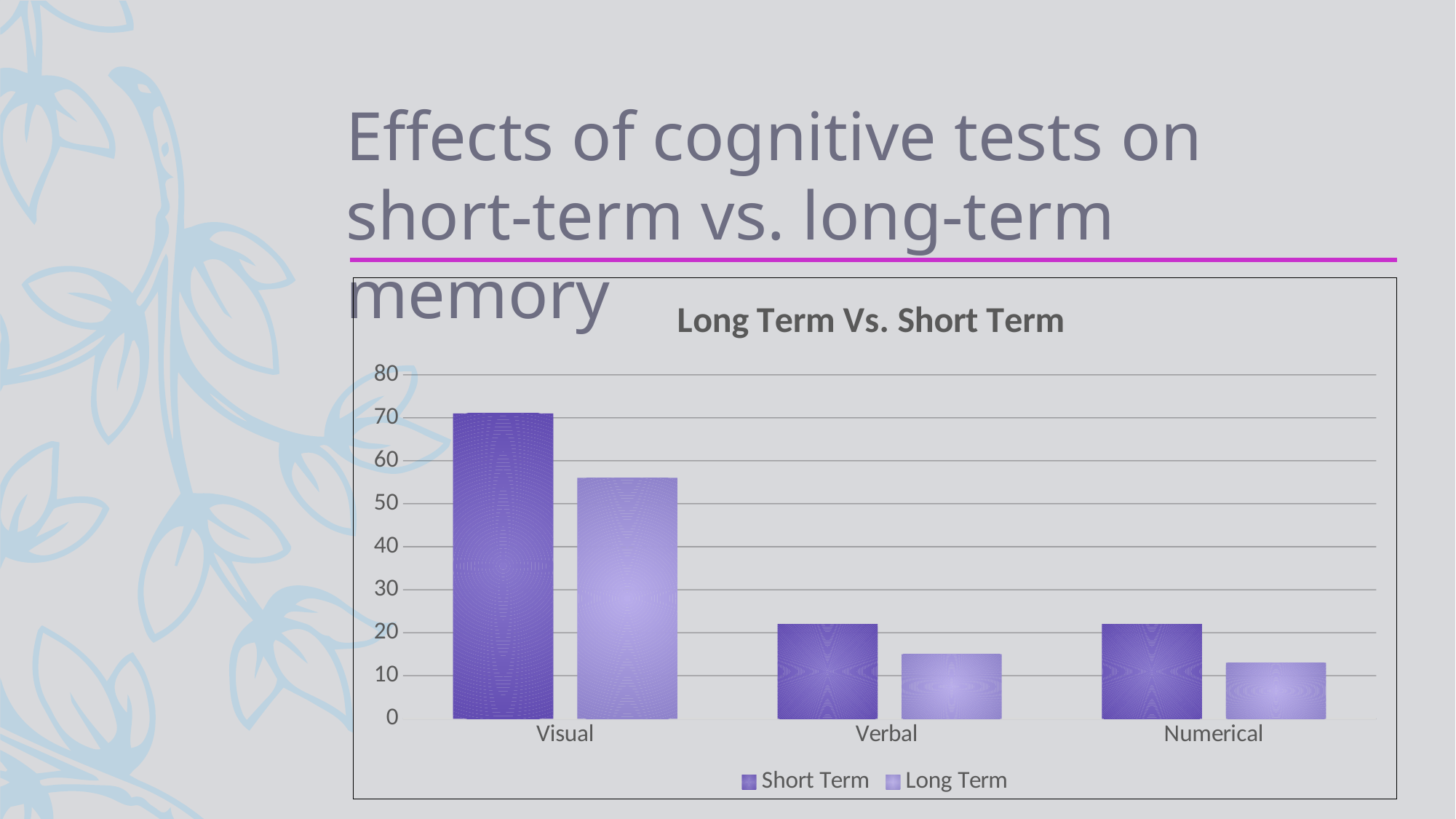
Which category has the highest Short Term value? Visual Is the Short Term value for Visual greater or less than 60? greater Do the Long Term values rise or fall from Visual to Numerical along the x axis? fall What type of chart is shown on the slide? bar chart For the Verbal category, which is larger: Short Term or Long Term? Short Term What is the title of the chart? Long Term Vs. Short Term How many series does the chart legend list? 2 Which category has the highest Long Term value? Visual For the Visual category, which is larger: Short Term or Long Term? Short Term Is the Long Term value for Numerical greater or less than 20? less Is the Long Term value for Visual greater or less than 60? less How many categories are shown on the x axis of the chart? 3